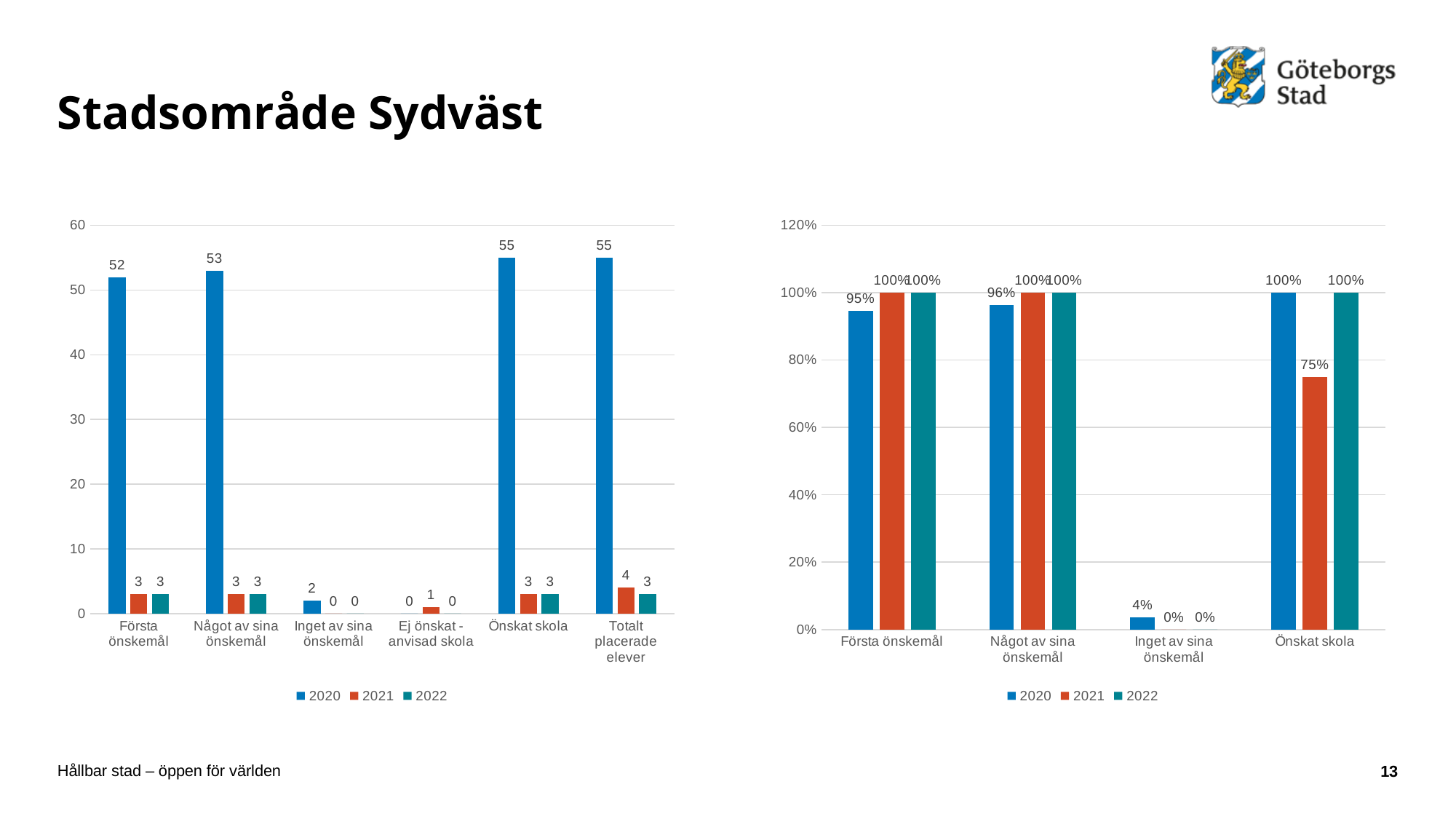
In the left chart, is the 2020 value for Något av sina önskemål greater or less than 50? greater In the right chart, what is the value for 2020 in the category Inget av sina önskemål? 4% In the right chart, what is the value for 2021 in the category Önskat skola? 75% In the left chart, how many categories are shown on the x axis? 6 What kind of chart is the left chart? Bar chart In the left chart, what is the difference between the 2020 values for Totalt placerade elever and Första önskemål? 3 In the right chart, which series has the lowest value in the category Önskat skola? 2021 In the right chart, what is the difference between the 2021 and 2020 values for Första önskemål? 5% In the left chart, what is the value for 2021 in the category Totalt placerade elever? 4 How many series does the legend of the right chart list? 3 In the left chart, what is the value for 2021 in the category Ej önskat - anvisad skola? 1 In the left chart, what is the value for 2020 in the category Första önskemål? 52